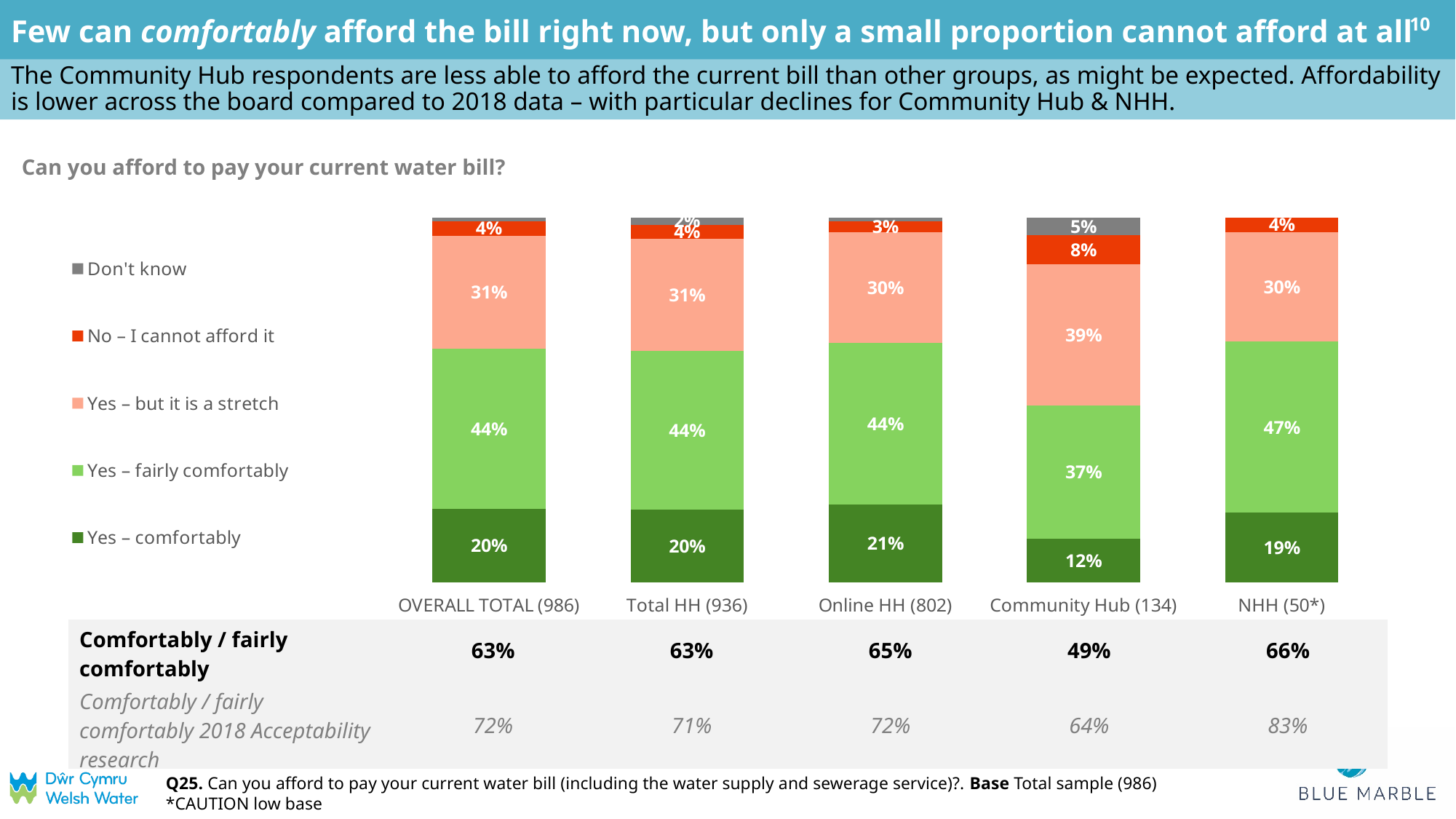
Which group has the lowest "Yes – comfortably" percentage? Community Hub (134) What type of chart is used to show the responses? Stacked bar chart What percentage of NHH (50*) respondents answered "Yes – fairly comfortably"? 47% What is the "Yes – but it is a stretch" value for Community Hub (134)? 39% How many response categories does the legend list? 5 How many respondent groups are shown as bars in the chart? 5 What is the difference in the "Yes – comfortably" percentage between Online HH (802) and Community Hub (134)? 9 percentage points Which group has a larger "Yes – but it is a stretch" share, Community Hub (134) or NHH (50*)? Community Hub (134) Which group has the highest "Yes – fairly comfortably" percentage? NHH (50*) What percentage of Community Hub (134) respondents answered "Yes – comfortably"? 12% What is the "Don't know" value for Community Hub (134)? 5% What is the "No – I cannot afford it" value for Community Hub (134)? 8%